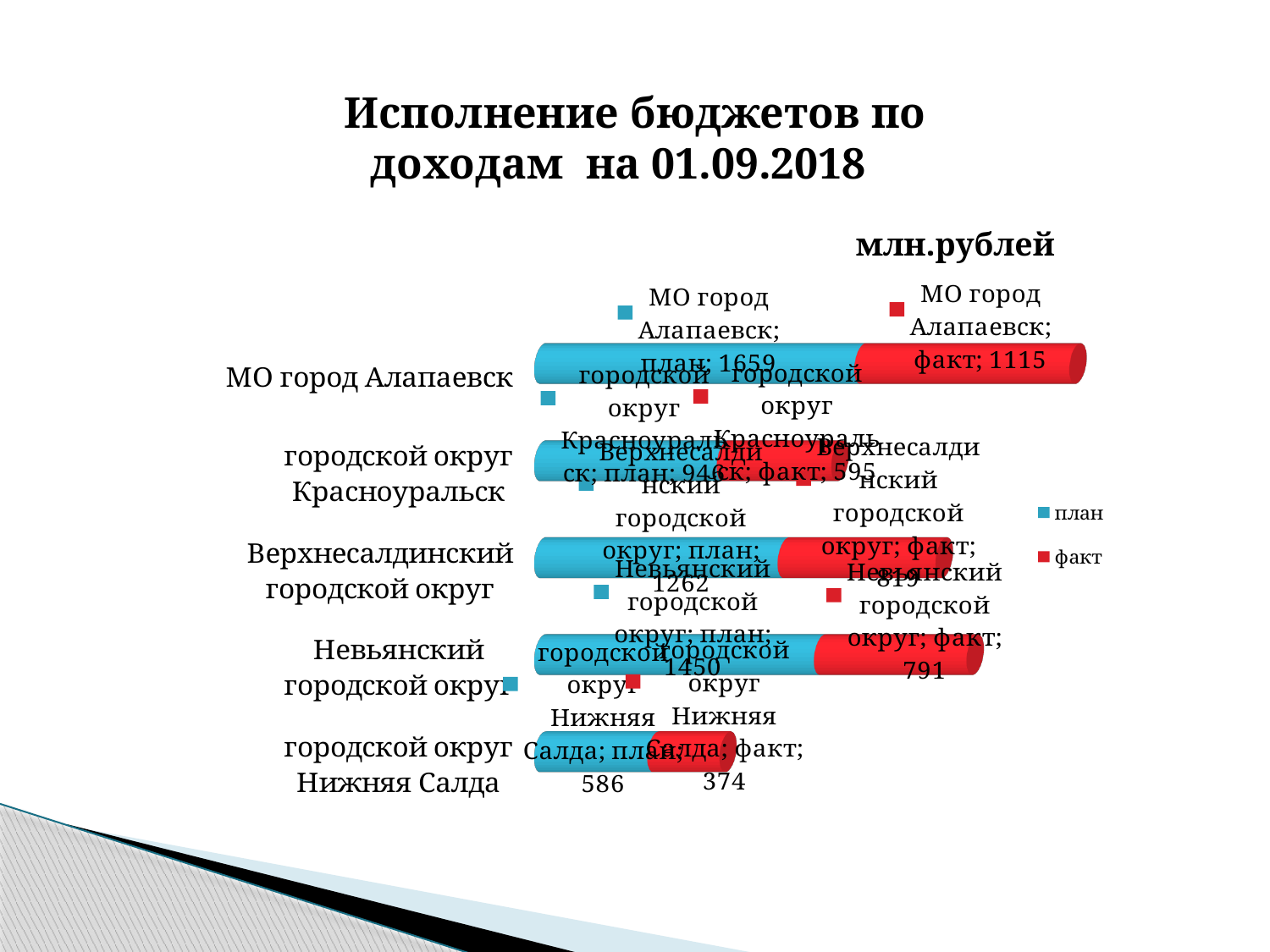
What is the difference between the план and факт values for МО город Алапаевск? 544 Which category has the highest план value? МО город Алапаевск How many series does the legend list? 2 Which category has the lowest факт value? городской округ Нижняя Салда What kind of chart is shown on the slide? bar chart What is the план value for городской округ Красноуральск? 946 What is the факт value for Невьянский городской округ? 791 Which is larger: the план value for Невьянский городской округ or the план value for Верхнесалдинский городской округ? Невьянский городской округ What is the факт value for МО город Алапаевск? 1115 What is the план value for городской округ Нижняя Салда? 586 What is the план value for МО город Алапаевск? 1659 How many categories are shown in the chart? 5